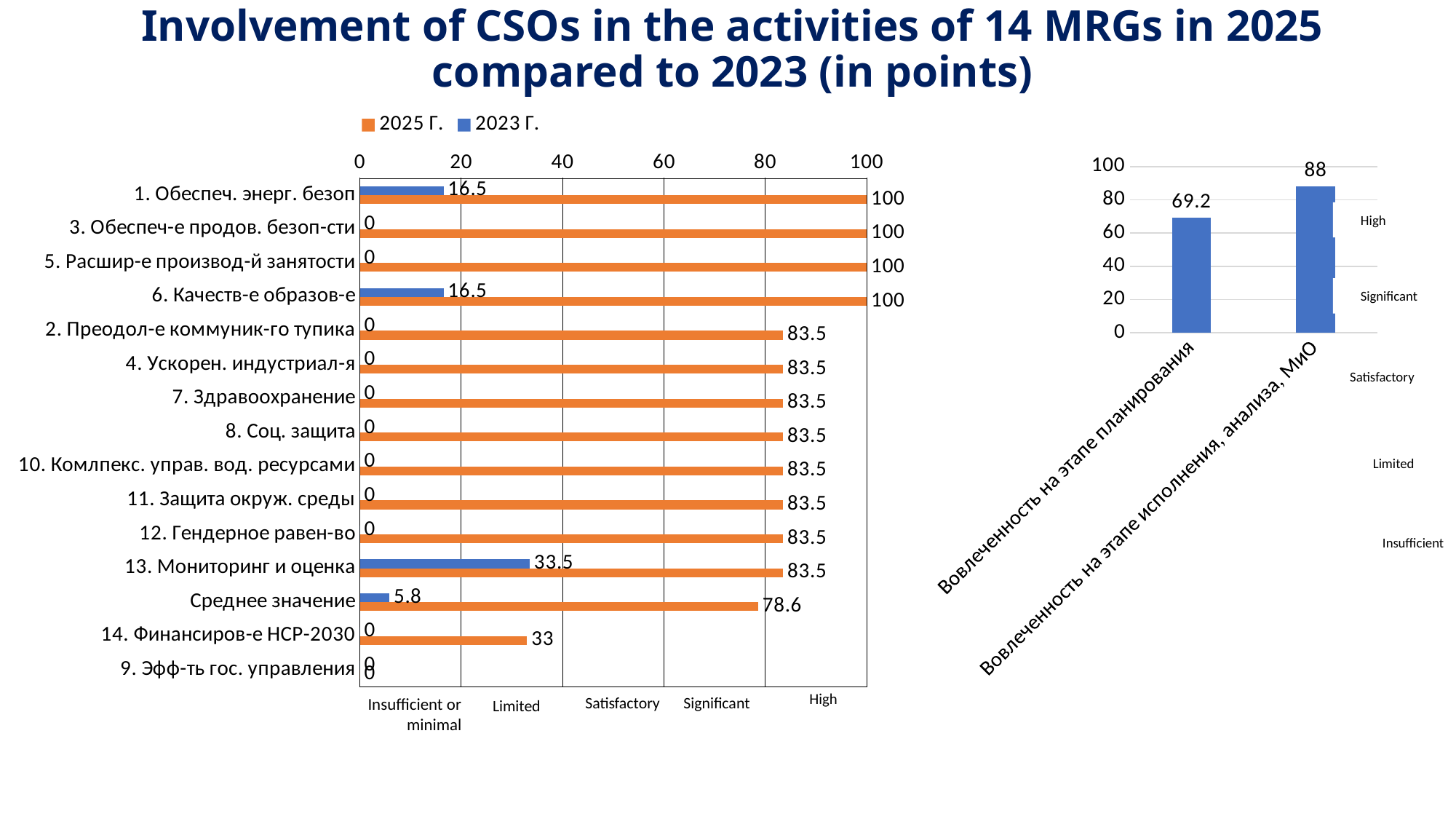
In the left chart, what is the 2025 г. value for Среднее значение? 78.6 What type of chart is the chart on the right? Bar chart In the right chart, what is the difference between the value for Вовлеченность на этапе исполнения, анализа, МиО and the value for Вовлеченность на этапе планирования? 18.8 In the right chart, what is the value for Вовлеченность на этапе планирования? 69.2 In the left chart, what is the 2023 г. value for 13. Мониторинг и оценка? 33.5 In the left chart, what is the 2025 г. value for 14. Финансиров-е НСР-2030? 33 In the left chart, how many series does the legend list? 2 In the left chart, what is the 2025 г. value for 13. Мониторинг и оценка? 83.5 In the left chart, which category has the lowest 2025 г. value? 9. Эфф-ть гос. управления In the left chart, what is the difference between the 2025 г. and 2023 г. values for 13. Мониторинг и оценка? 50 In the left chart, what is the 2023 г. value for Среднее значение? 5.8 In the left chart, how many categories are shown on the vertical axis? 15